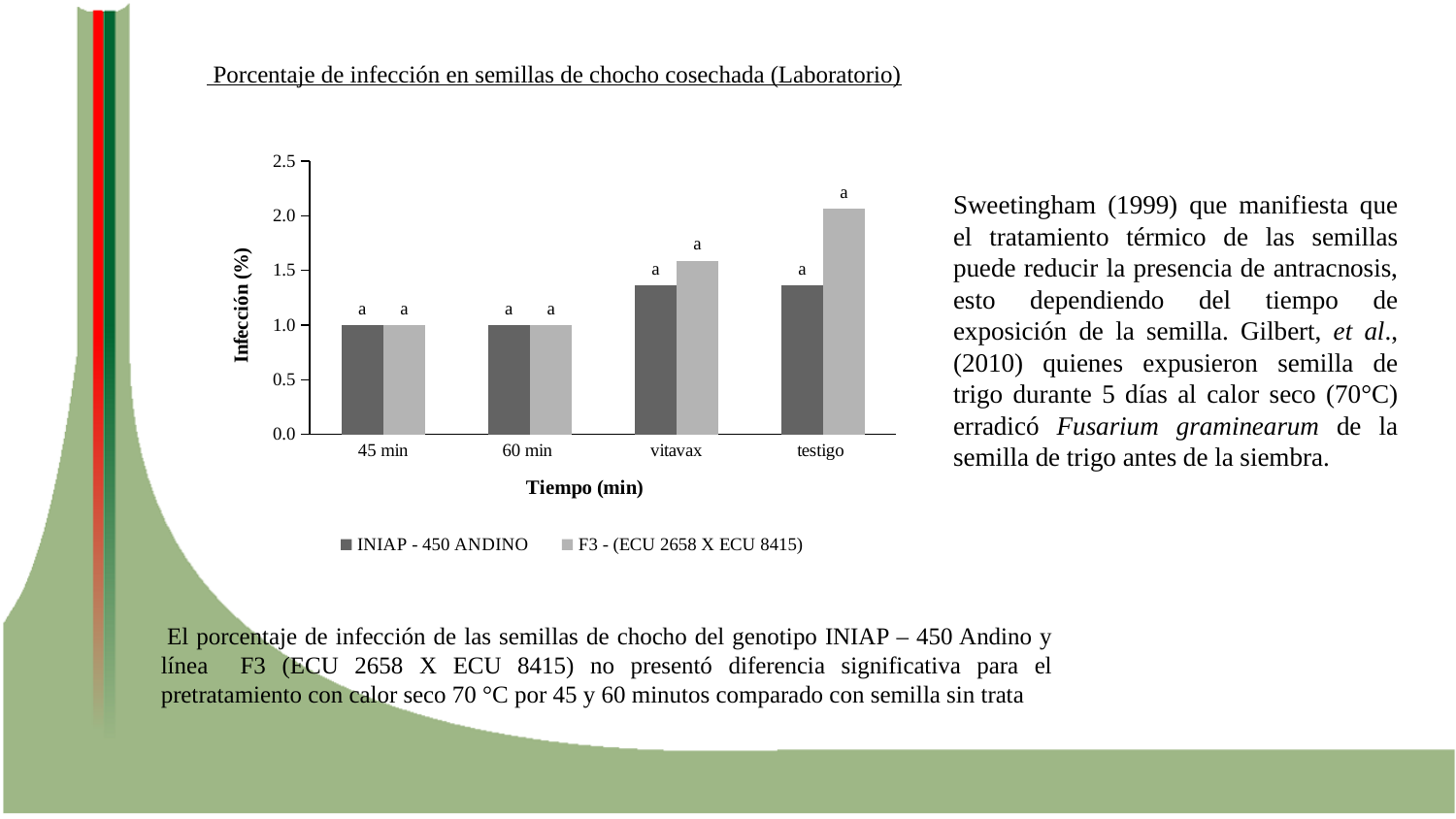
Is the value for F3 - (ECU 2658 X ECU 8415) at testigo greater or less than 1.5? greater Which category has the highest value for F3 - (ECU 2658 X ECU 8415)? testigo What is the title of the x axis? Tiempo (min) How many series does the legend list? 2 What is the value for INIAP - 450 ANDINO at 45 min? 1.0 Is the value for INIAP - 450 ANDINO at testigo greater or less than 1.5? less How many categories are shown on the x axis? 4 What is the value for F3 - (ECU 2658 X ECU 8415) at 60 min? 1.0 What kind of chart is shown on the slide? bar chart What is the title of the y axis? Infección (%) At testigo, which series has the larger value, INIAP - 450 ANDINO or F3 - (ECU 2658 X ECU 8415)? F3 - (ECU 2658 X ECU 8415) Is the value for F3 - (ECU 2658 X ECU 8415) at vitavax greater or less than 2.0? less